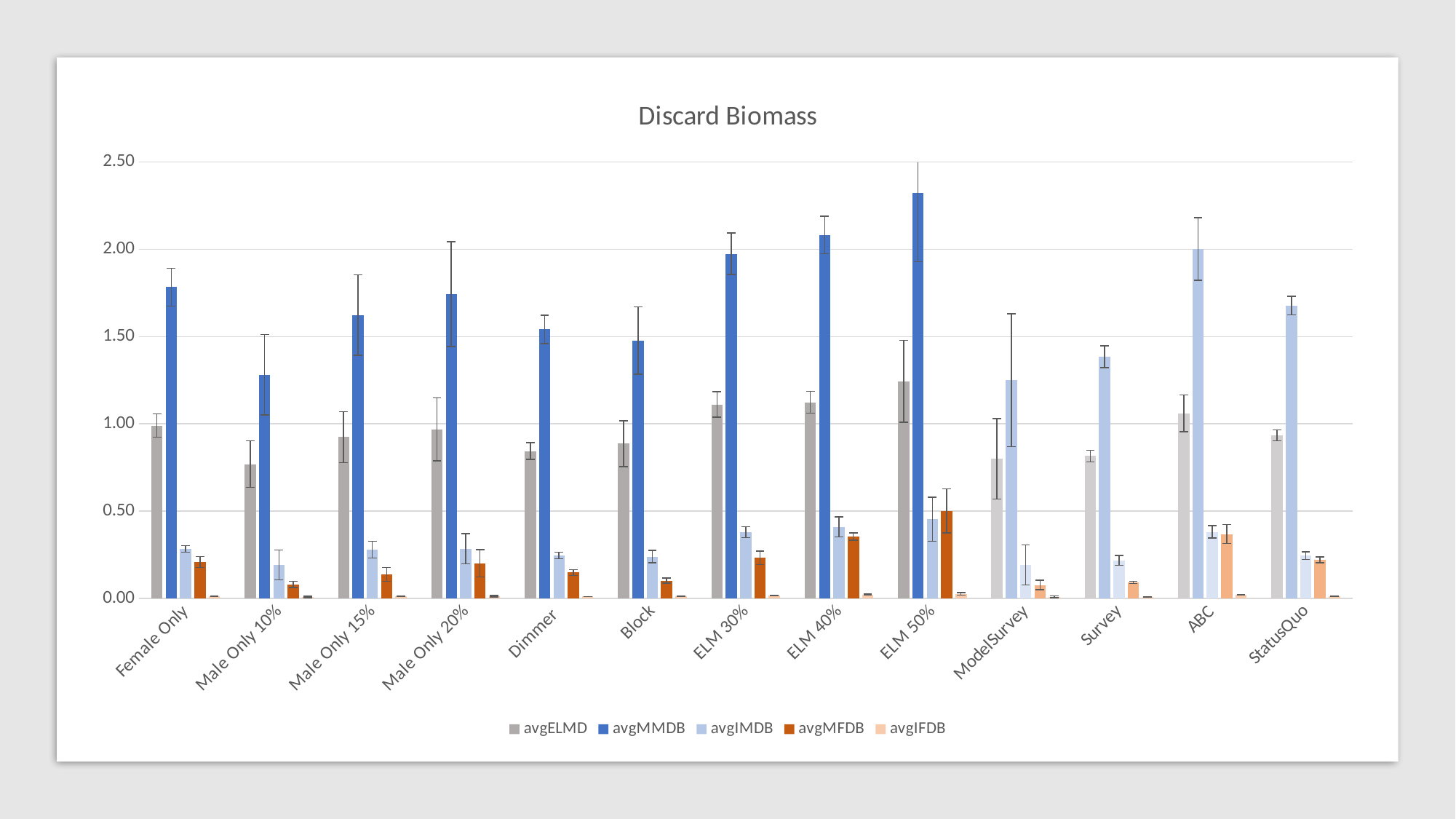
Is the avgMMDB value for Male Only 10% greater or less than 1.50? less What is the title of the chart? Discard Biomass How many series does the legend list? 5 Is the avgMMDB value for ELM 50% greater or less than 2.00? greater Which is larger, the avgIMDB value for ABC or for StatusQuo? ABC Which is larger, the avgMMDB value for Female Only or for Male Only 10%? Female Only Which category has the highest avgMMDB value? ELM 50% Which category has the highest avgELMD value? ELM 50% Is the avgIMDB value for Survey greater or less than 1.50? less How many categories are shown along the x axis? 13 What kind of chart is shown on the slide? bar chart Which category has the highest avgIMDB value? ABC